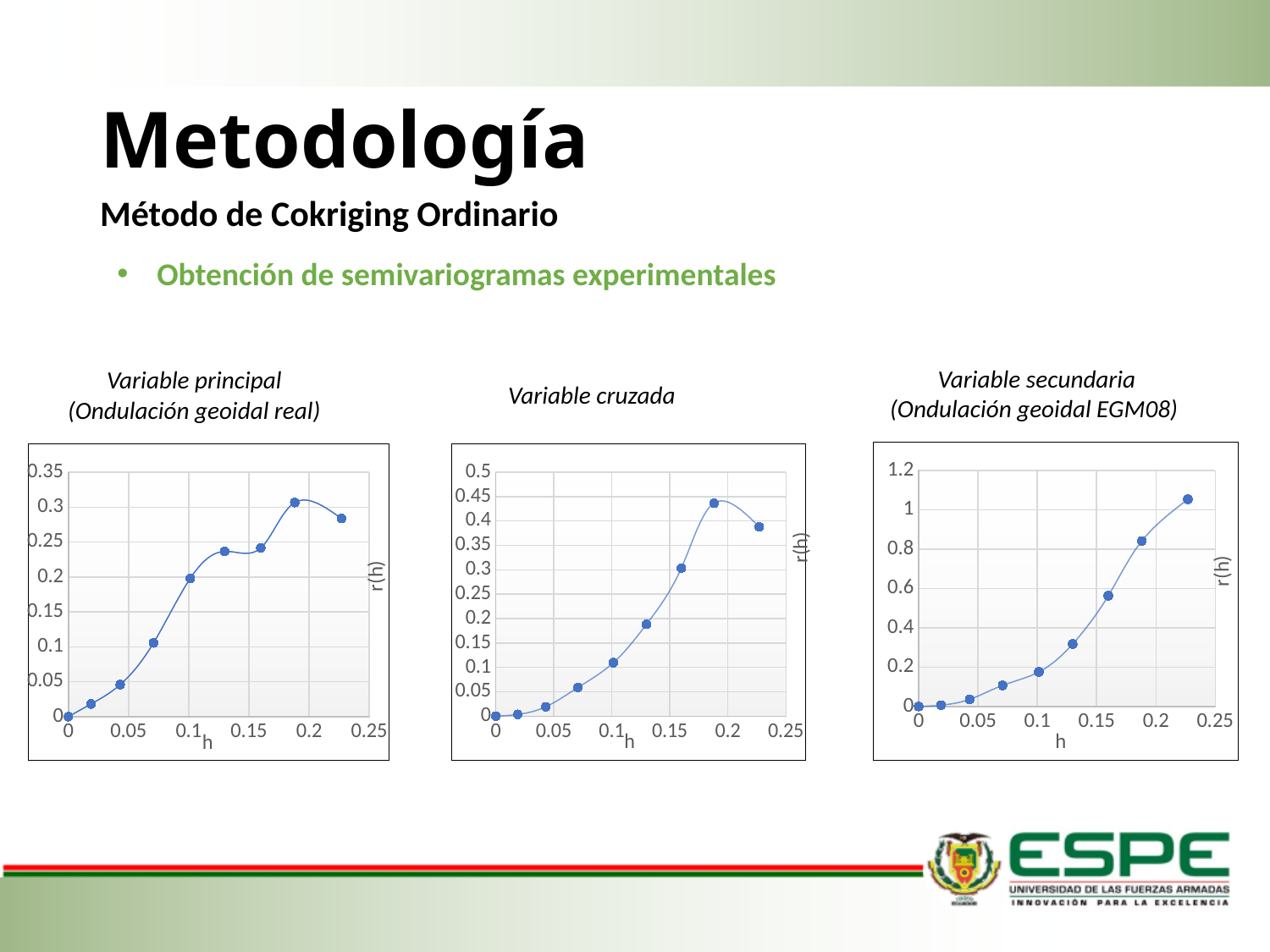
How many data points are plotted in the 'Variable secundaria (Ondulación geoidal EGM08)' chart on the right? 9 What is the label of the horizontal axis in the 'Variable cruzada' chart in the middle? h What kind of chart is the 'Variable principal (Ondulación geoidal real)' chart on the left? line chart In the 'Variable principal (Ondulación geoidal real)' chart on the left, is the value at h of about 0.16 greater or less than 0.2? greater Which chart reaches the highest r(h) value: 'Variable cruzada' in the middle or 'Variable secundaria (Ondulación geoidal EGM08)' on the right? Variable secundaria (Ondulación geoidal EGM08) In the 'Variable cruzada' chart in the middle, do the values generally rise or fall as h increases from 0 to about 0.19? rise What is the highest tick value shown on the vertical axis of the 'Variable secundaria (Ondulación geoidal EGM08)' chart on the right? 1.2 In the 'Variable principal (Ondulación geoidal real)' chart on the left, which is larger: the value at h of about 0.19 or the value at h of about 0.225? the value at h of about 0.19 In the 'Variable secundaria (Ondulación geoidal EGM08)' chart on the right, is the value of the last point (at h of about 0.225) greater or less than 1? greater How many data points are plotted in the 'Variable principal (Ondulación geoidal real)' chart on the left? 9 In the 'Variable cruzada' chart in the middle, is the highest point greater or less than 0.4? greater